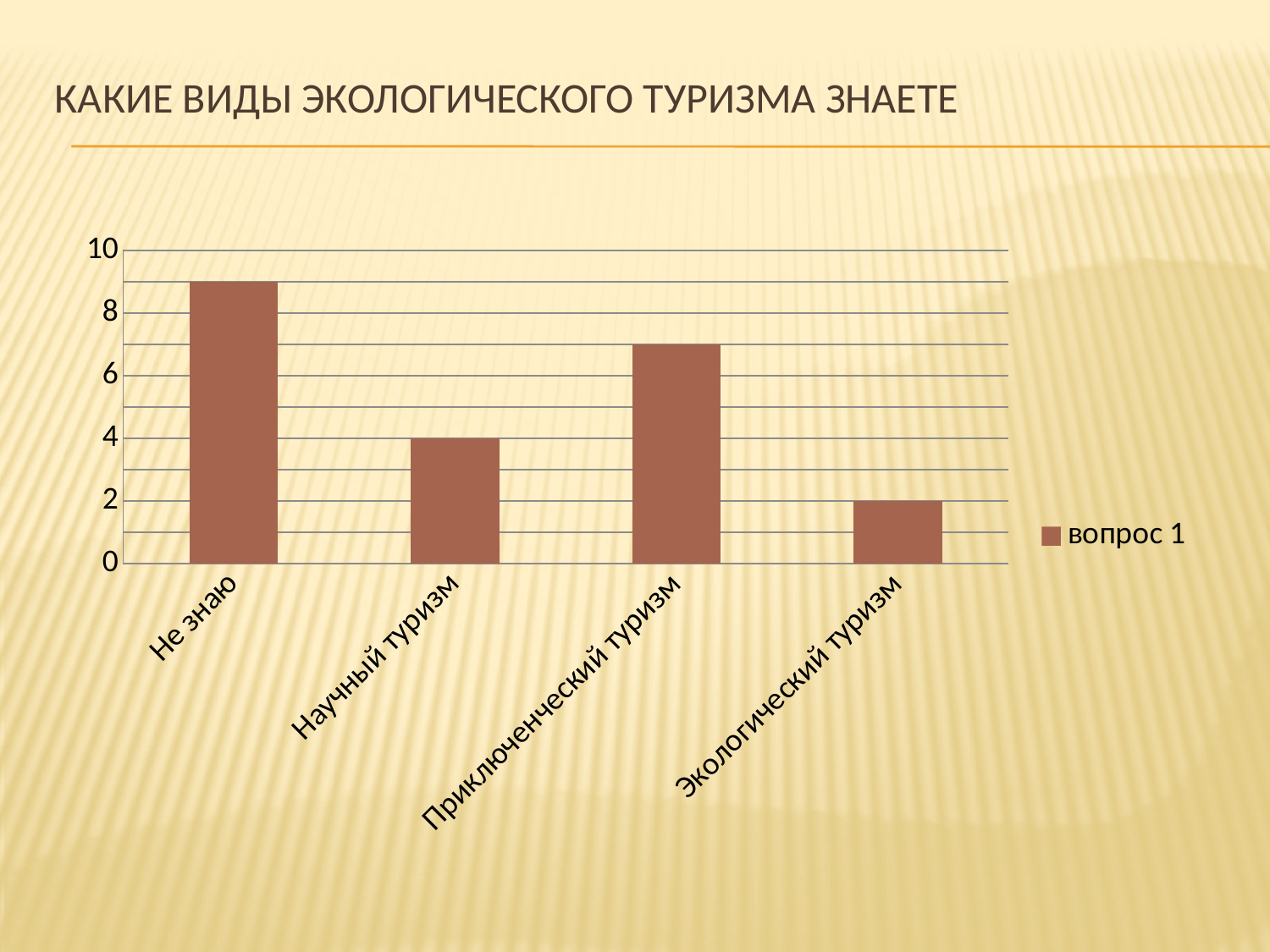
What is the name of the series shown in the legend? вопрос 1 Is the value for Приключенческий туризм greater or less than 6? greater What kind of chart is shown on the slide? bar chart Which category has the highest bar? Не знаю What is the difference between the values for Научный туризм and Экологический туризм? 2 Is the value for Не знаю greater or less than 8? greater How many categories are shown on the x axis? 4 How many series does the legend list? 1 What is the value for Экологический туризм? 2 Which is larger, the value for Приключенческий туризм or the value for Научный туризм? Приключенческий туризм Which category has the lowest bar? Экологический туризм What is the value for Научный туризм? 4